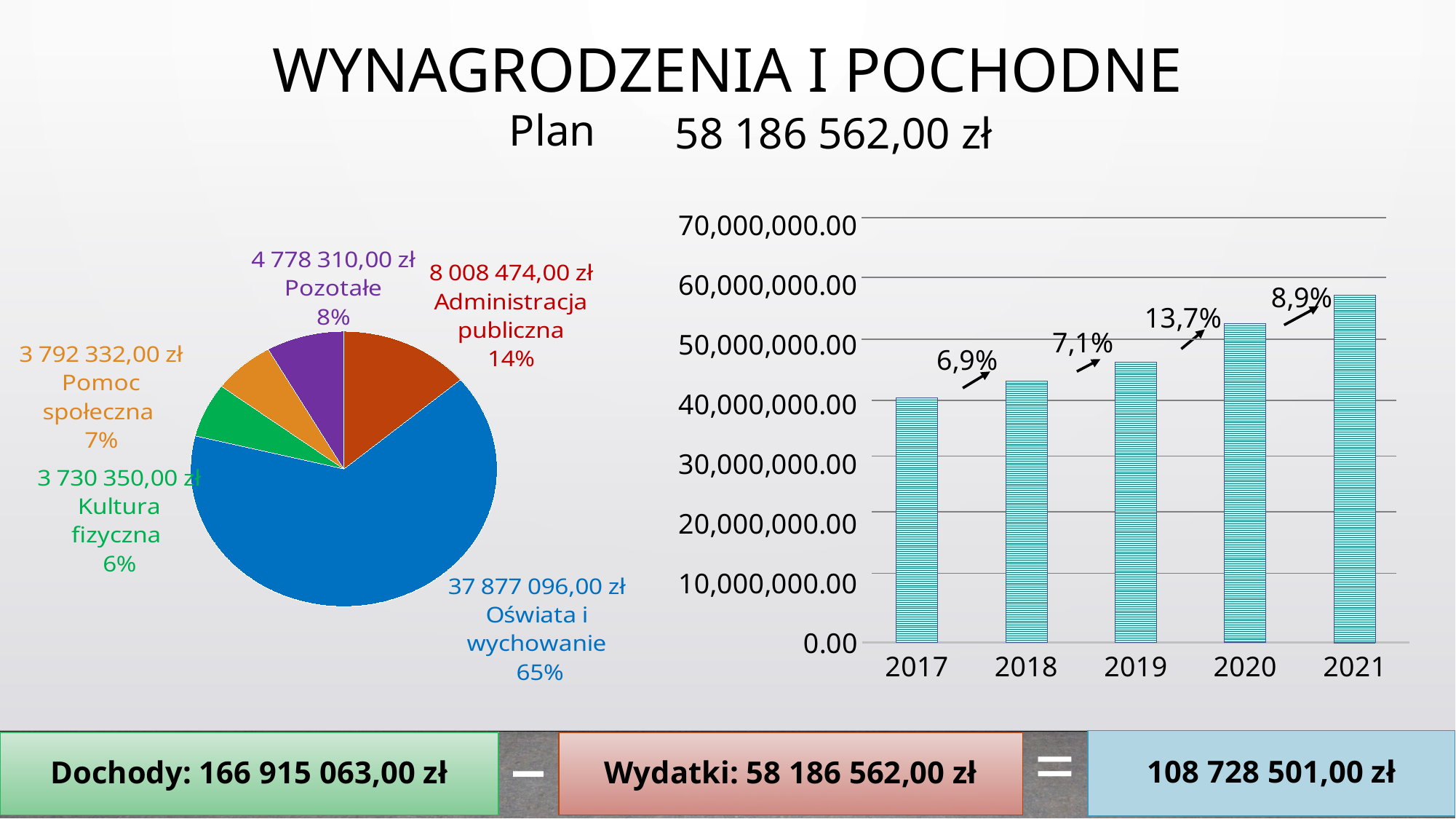
In the pie chart on the left, what is the value for Administracja publiczna? 8 008 474,00 zł In the pie chart on the left, what is the value for Oświata i wychowanie? 37 877 096,00 zł In the bar chart on the right, which year has a larger value, 2018 or 2020? 2020 In the pie chart on the left, what share of the pie does Pomoc społeczna represent? 7% In the bar chart on the right, how many years are shown on the x axis? 5 In the pie chart on the left, what is the difference between the values for Administracja publiczna and Pozotałe? 3 230 164,00 zł What kind of chart is shown on the right side of the slide? Bar chart In the bar chart on the right, do the values rise or fall from 2017 to 2021? rise How many slices does the pie chart on the left have? 5 In the bar chart on the right, is the value for 2017 greater or less than 50,000,000.00? less In the pie chart on the left, which category has the smallest slice? Kultura fizyczna In the pie chart on the left, which category has the largest slice? Oświata i wychowanie